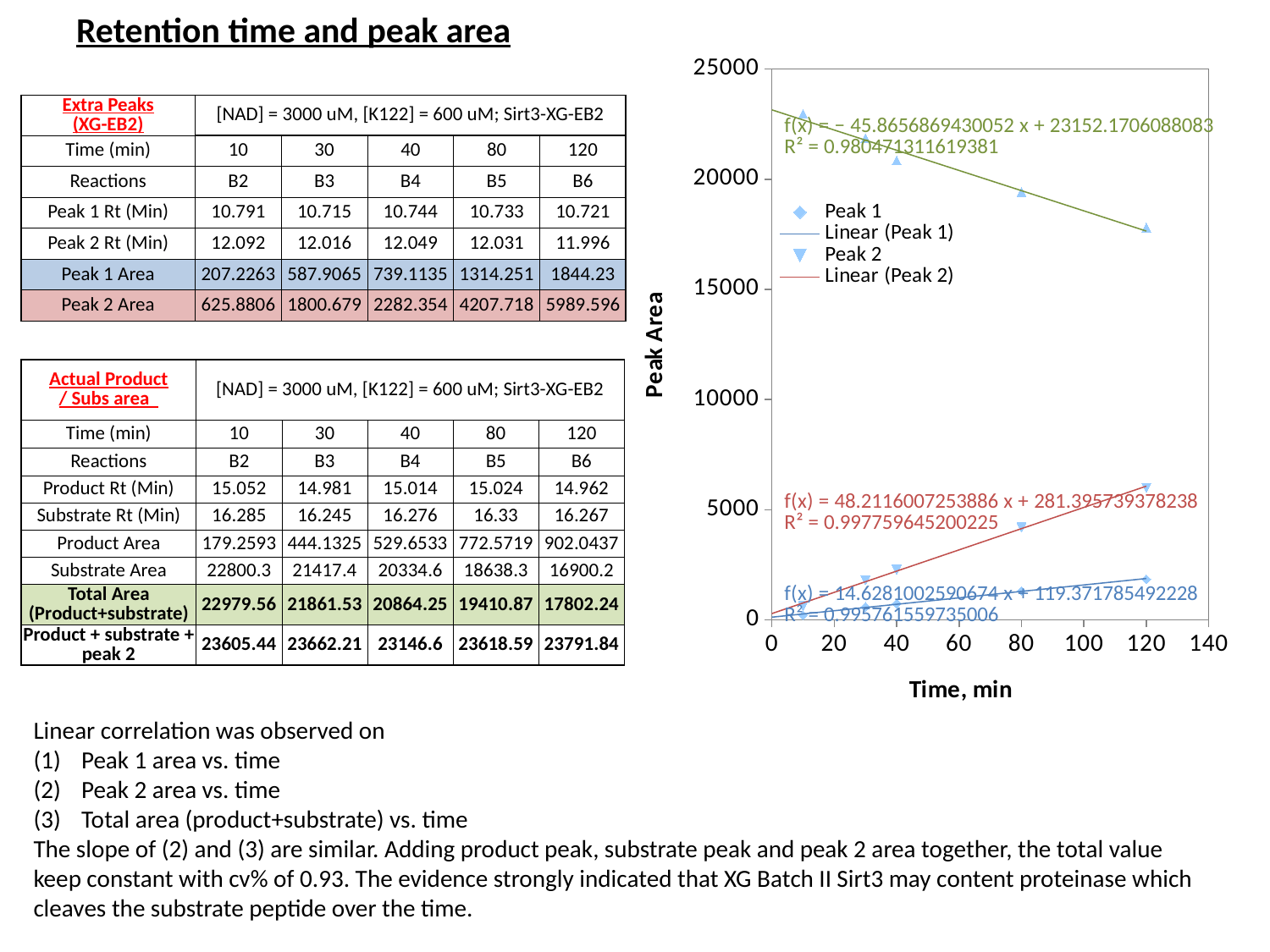
What is the title of the y axis of the chart? Peak Area At 120 min, which is larger: the Peak 1 value or the Peak 2 value? Peak 2 Do the Peak 2 values rise or fall as time increases along the x axis? rise Do the values of the green-triangle series at the top of the chart rise or fall as time increases? fall What kind of chart is shown on the slide? scatter chart How many data points are plotted for the Peak 2 series? 5 Is the Peak 1 value at 120 min greater or less than 5000? less How many entries does the chart legend list? 4 What R² value is shown for the trendline with the equation f(x) = 48.2116007253886 x + 281.395739378238? 0.997759645200225 What is the title of the x axis of the chart? Time, min Is the Peak 2 value at 120 min greater or less than 5000? greater Is the value of the green-triangle series at 120 min greater or less than 20000? less